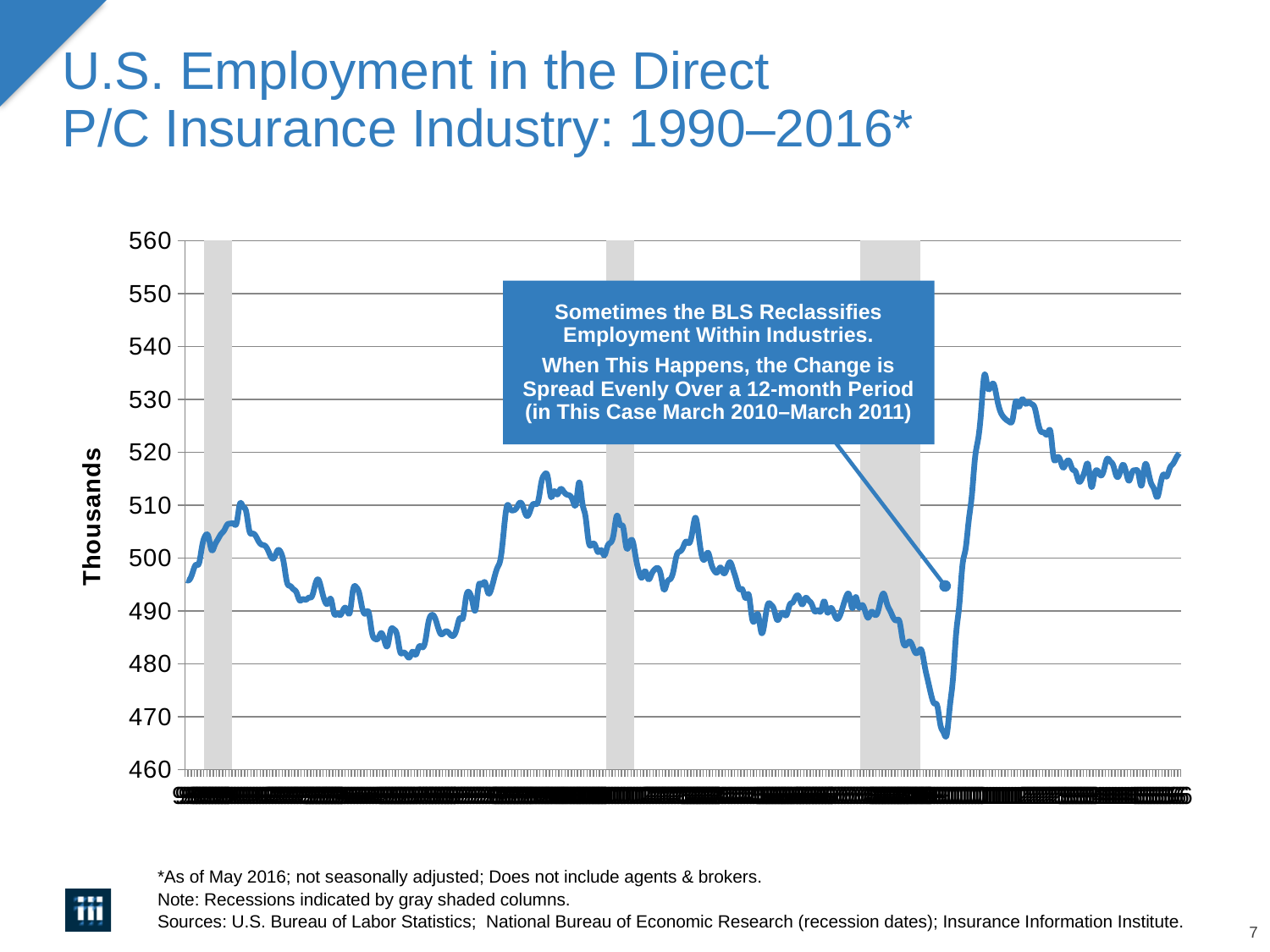
Is the lowest point of the line greater or less than 470? less What is the highest value shown on the vertical axis? 560 What kind of chart is shown on the slide? line chart What is the title of the chart on the slide? U.S. Employment in the Direct P/C Insurance Industry: 1990–2016* How many data series are plotted on the chart? 1 What is the label on the vertical axis of the chart? Thousands Is the value at the end of the line (right end) greater or less than 530? less Is the highest point of the line greater or less than 530? greater Comparing the start of the line to its end, do the values rise or fall overall? rise Which is larger: the value at the left end of the line or the value at the right end of the line? the right end